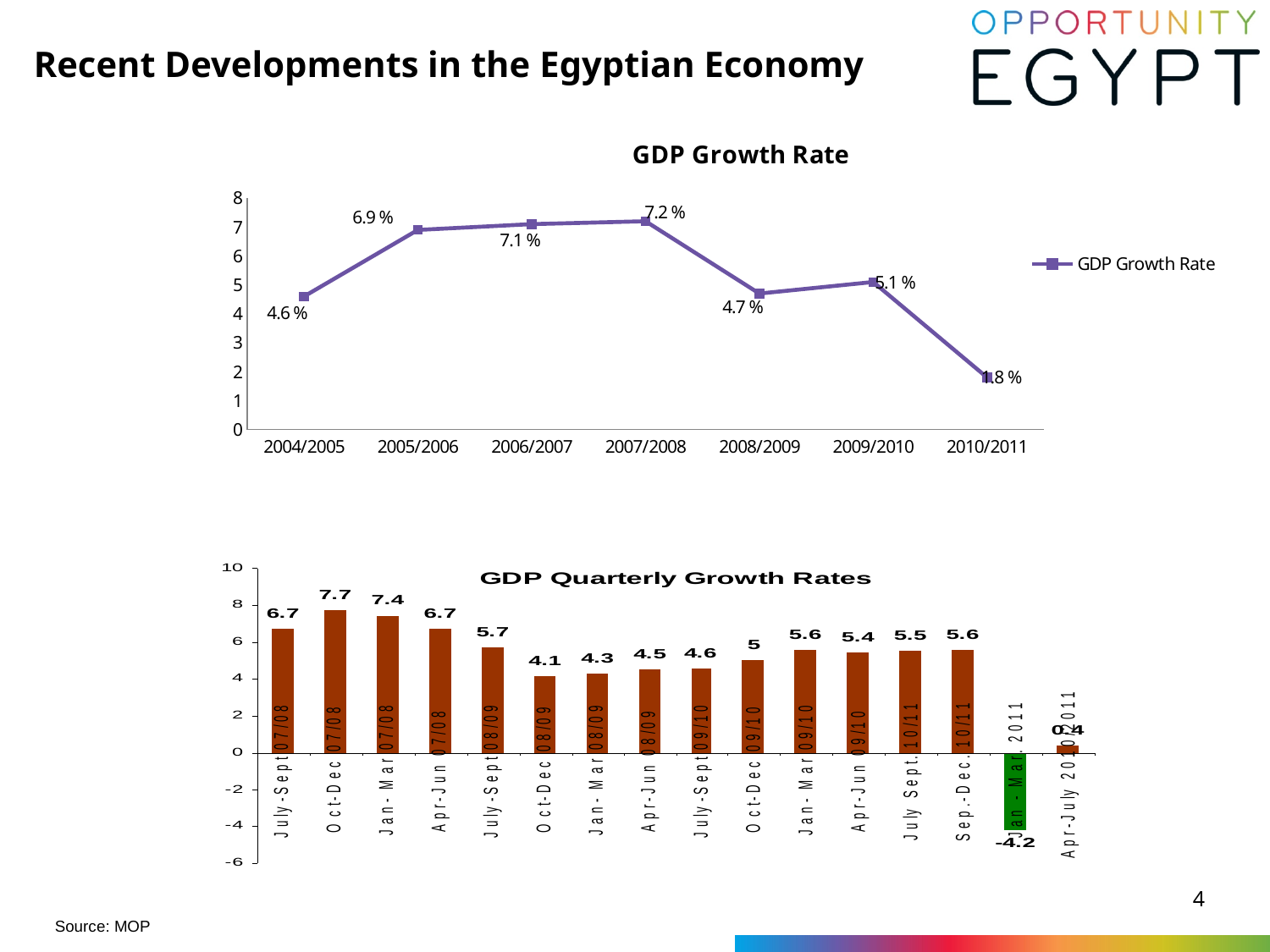
In the GDP Growth Rate chart, how many years are plotted on the x axis? 7 In the GDP Growth Rate chart, which year has the lowest GDP growth rate? 2010/2011 In the GDP Quarterly Growth Rates chart, what is the value for Apr-July 2011? 0.4 In the GDP Quarterly Growth Rates chart, what is the value for Oct-Dec 07/08? 7.7 In the GDP Quarterly Growth Rates chart, which quarter has the lowest value? Jan-Mar 2011 What kind of chart is the GDP Quarterly Growth Rates chart? Bar chart In the GDP Quarterly Growth Rates chart, which is larger, the value for Jan-Mar 09/10 or the value for Apr-Jun 09/10? Jan-Mar 09/10 In the GDP Growth Rate chart, what is the GDP growth rate for 2007/2008? 7.2% In the GDP Growth Rate chart, what is the difference between the growth rates for 2005/2006 and 2004/2005? 2.3 percentage points What kind of chart is the GDP Growth Rate chart? Line chart In the GDP Growth Rate chart, which year has the highest GDP growth rate? 2007/2008 In the GDP Growth Rate chart, does the growth rate rise or fall from 2007/2008 to 2010/2011? Fall